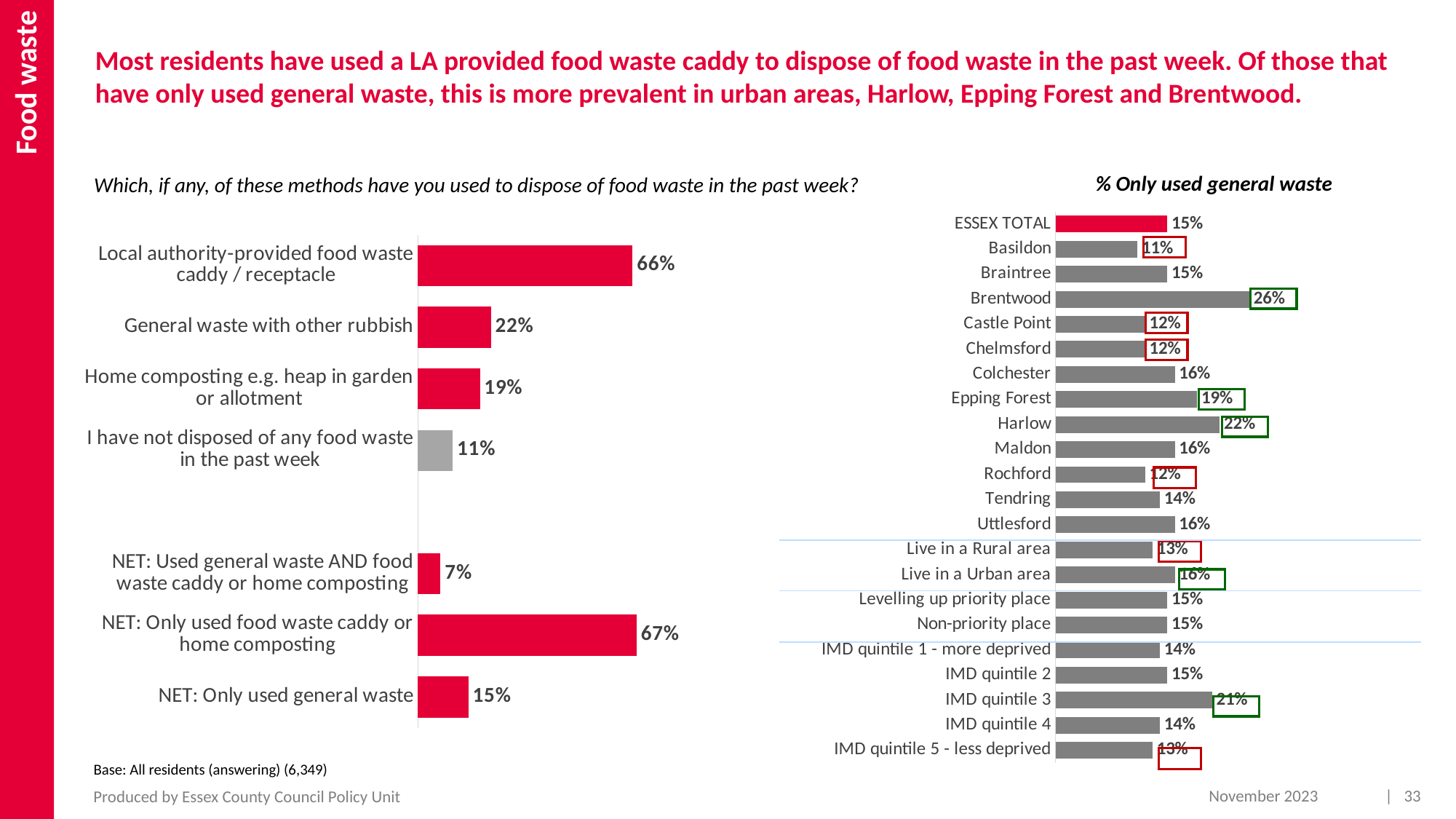
In the '% Only used general waste' chart, what is the difference between Brentwood and Basildon? 15% What type of chart is the '% Only used general waste' chart? Bar chart In the '% Only used general waste' chart, what is the value for ESSEX TOTAL? 15% In the left chart on methods used to dispose of food waste, what percentage used a local authority-provided food waste caddy / receptacle? 66% In the '% Only used general waste' chart, which is larger, Harlow or Epping Forest? Harlow In the left chart on methods used to dispose of food waste, which bar is shown in grey rather than red? I have not disposed of any food waste in the past week In the left chart on methods used to dispose of food waste, what is the value for 'NET: Used general waste AND food waste caddy or home composting'? 7% In the left chart on methods used to dispose of food waste, what percentage used general waste with other rubbish? 22% In the '% Only used general waste' chart, what is the value for Brentwood? 26% In the left chart on methods used to dispose of food waste, what is the difference between 'General waste with other rubbish' and 'Home composting e.g. heap in garden or allotment'? 3% In the left chart on methods used to dispose of food waste, which category has the highest value? NET: Only used food waste caddy or home composting In the '% Only used general waste' chart, which district has the lowest value? Basildon